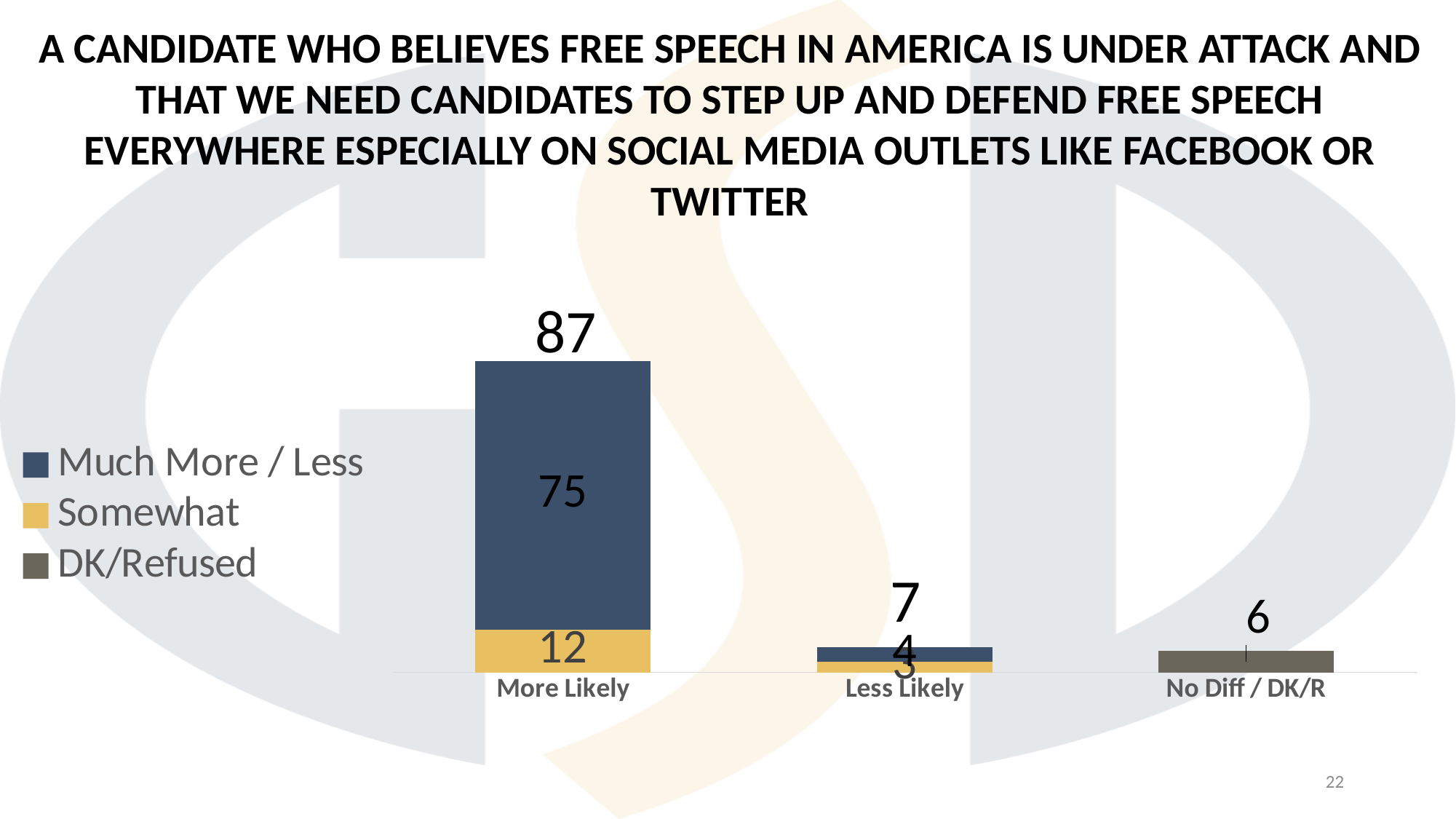
What is the Somewhat value for Less Likely? 3 What is the Somewhat value for More Likely? 12 What is the Much More / Less value for Less Likely? 4 What is the total of the stacked bar for Less Likely? 7 Which is larger, the Somewhat value for More Likely or the Somewhat value for Less Likely? More Likely What is the value for No Diff / DK/R? 6 What is the Much More / Less value for More Likely? 75 What is the total of the stacked bar for More Likely? 87 Which category has the highest total? More Likely How many categories are shown on the x axis? 3 How many series does the legend list? 3 What is the difference between the More Likely total and the Less Likely total? 80